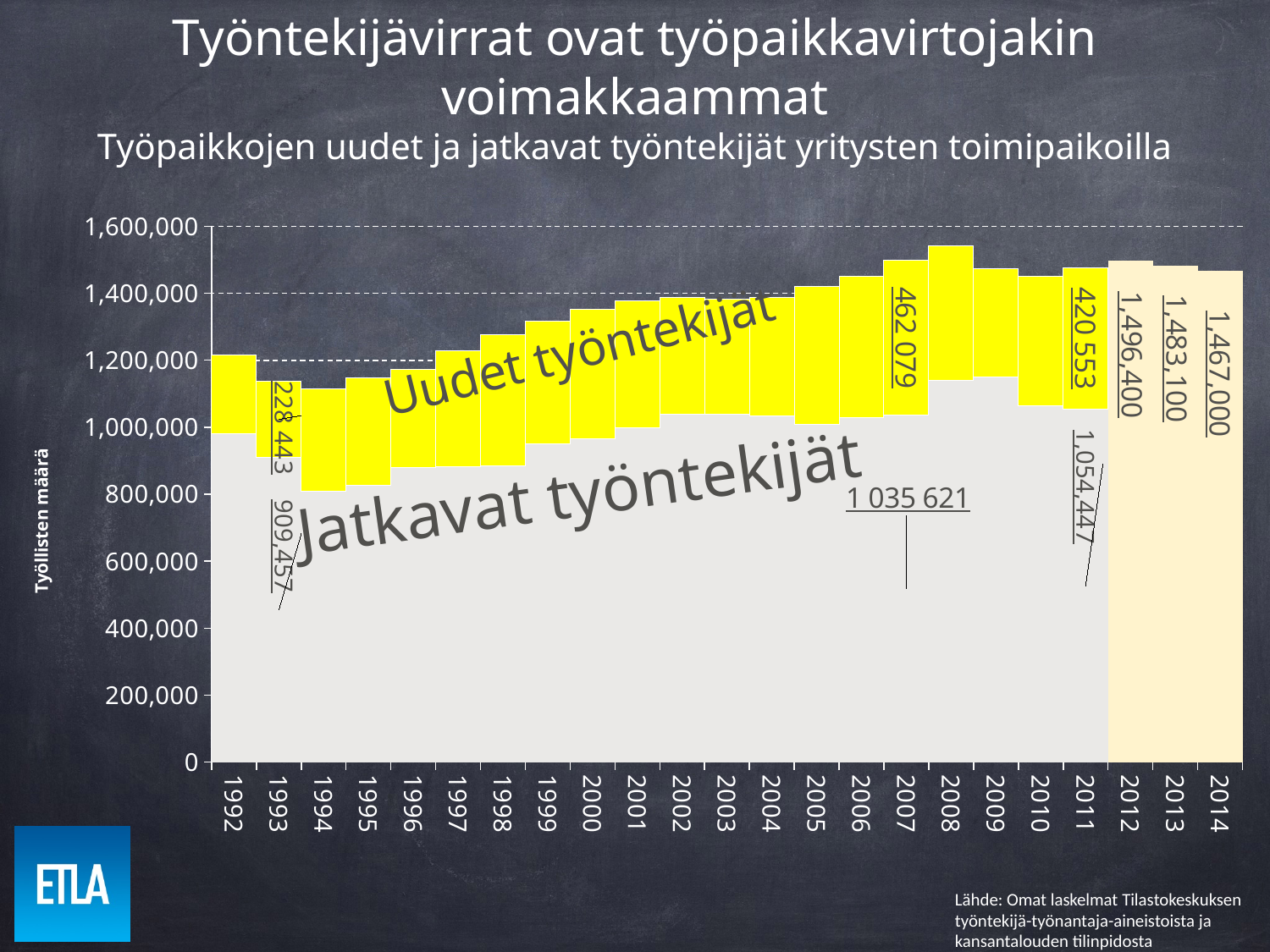
Is the total height of the 2008 bar greater or less than 1,400,000? greater How many years are shown on the x axis? 23 What is the label on the y axis? Työllisten määrä What is the labelled total value for 2012? 1,496,400 What is the difference between the number of new employees in 2007 and in 2011? 41,526 Which is larger, the labelled total for 2013 or for 2014? 2013 What is the number of continuing employees (Jatkavat työntekijät) in 2007? 1 035 621 What is the number of new employees (Uudet työntekijät) in 1993? 228 443 What is the number of continuing employees (Jatkavat työntekijät) in 2011? 1,054,447 What is the total number of employees (new plus continuing) in 1993? 1,137,900 What is the difference between the labelled totals for 2013 and 2014? 16,100 What kind of chart is shown on the slide? Stacked bar chart